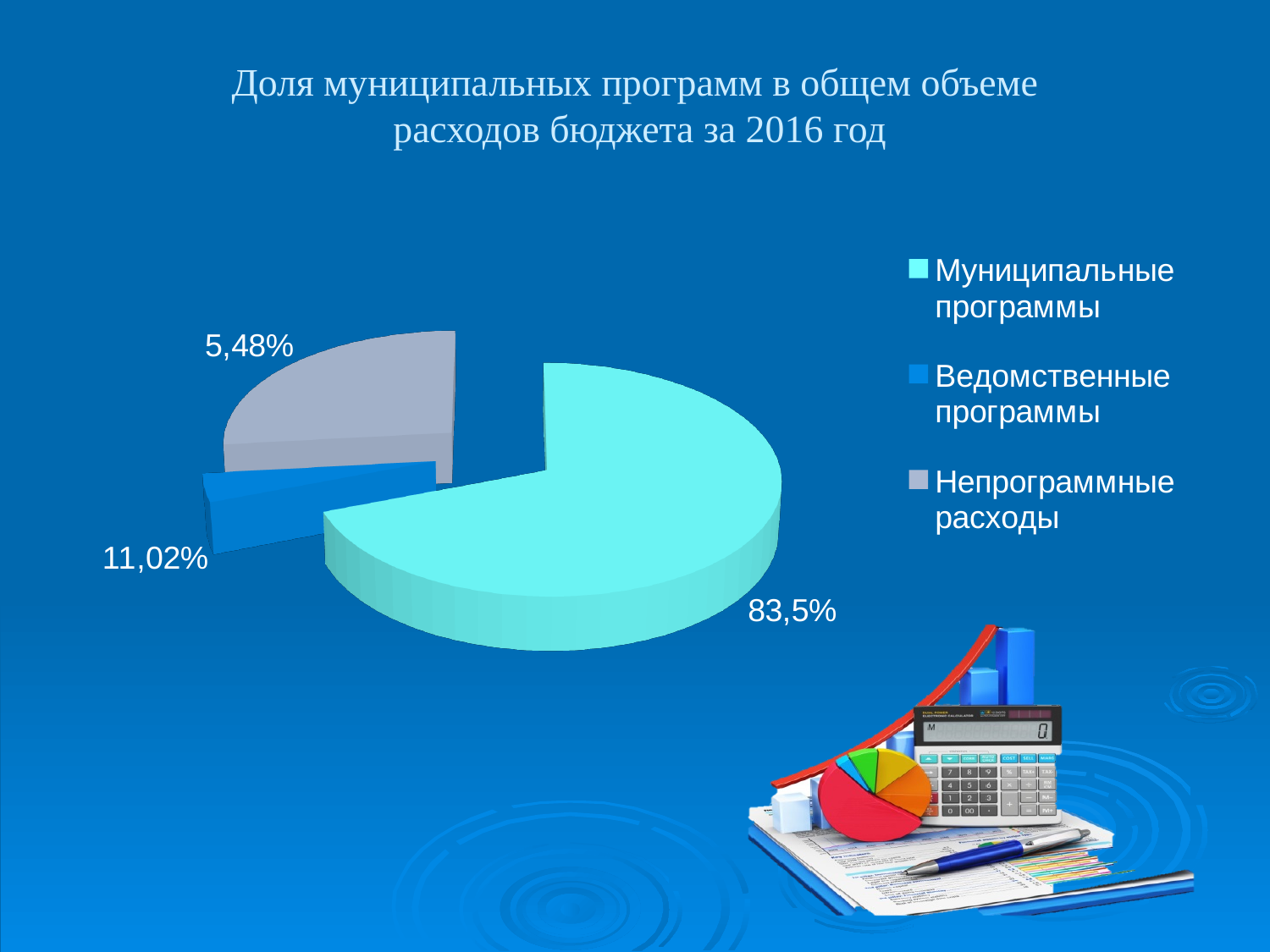
Which legend entry is shown in grey? Непрограммные расходы What is the value shown for Непрограммные расходы? 5,48% What share of the pie does Муниципальные программы have? 83,5% What is the value shown for Ведомственные программы? 11,02% What is the difference between the shares of Ведомственные программы and Непрограммные расходы? 5,54% How many slices does the pie chart have? 3 What is the difference between the shares of Муниципальные программы and Ведомственные программы? 72,48% What kind of chart is shown on the slide? Pie chart What is the title of the chart? Доля муниципальных программ в общем объеме расходов бюджета за 2016 год Which category has the largest slice of the pie? Муниципальные программы